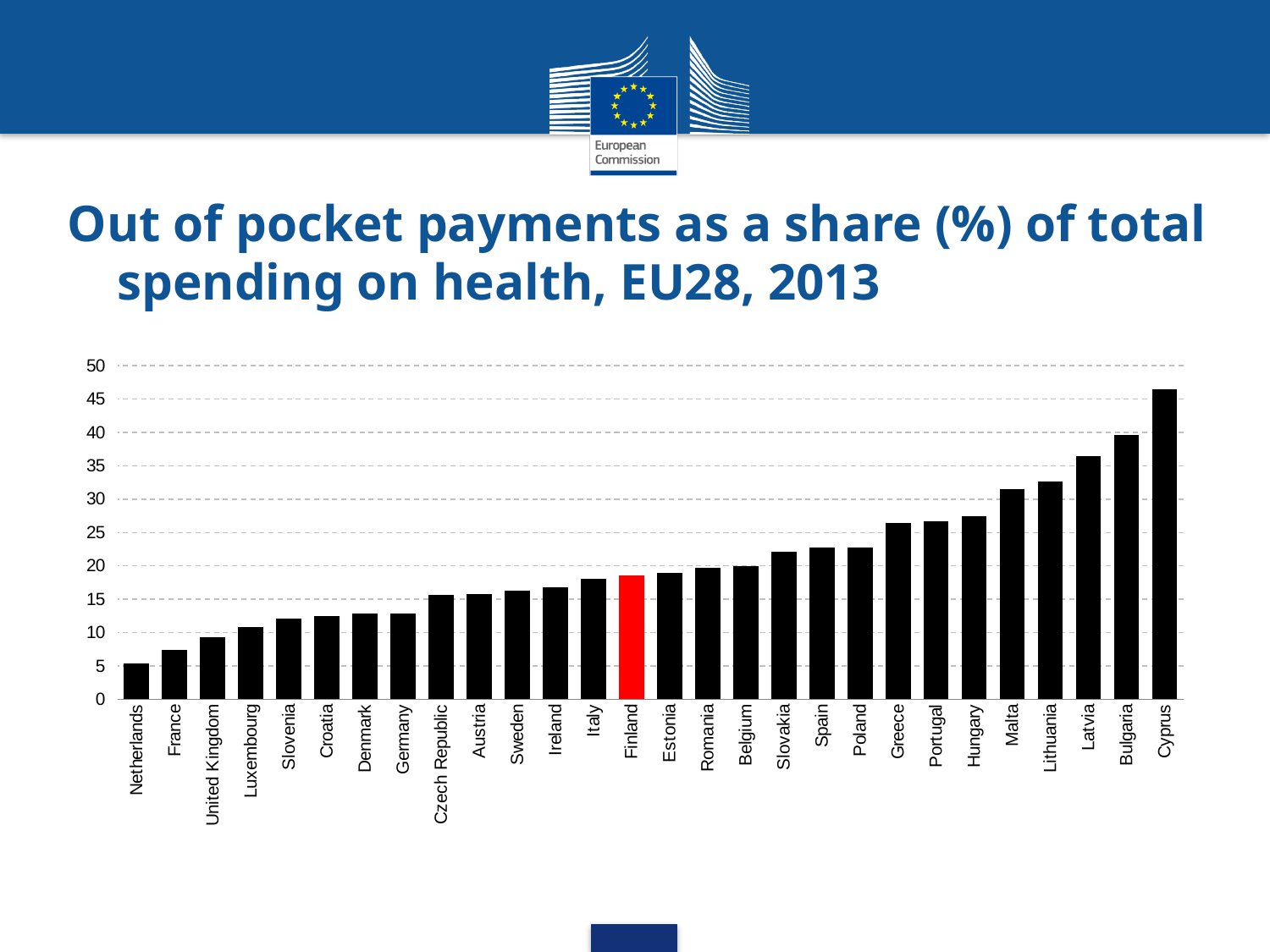
Is the value for Netherlands greater or less than 10? less What kind of chart is shown on the slide? bar chart How many countries are shown on the chart? 28 Which country has the highest out-of-pocket share? Cyprus Which country's bar is highlighted in red? Finland Is the value for Finland greater or less than 20? less Is the value for Cyprus greater or less than 40? greater Which country has the lowest out-of-pocket share? Netherlands Which has a larger value, Finland or Greece? Greece Do the values rise or fall moving from left to right along the x axis? rise